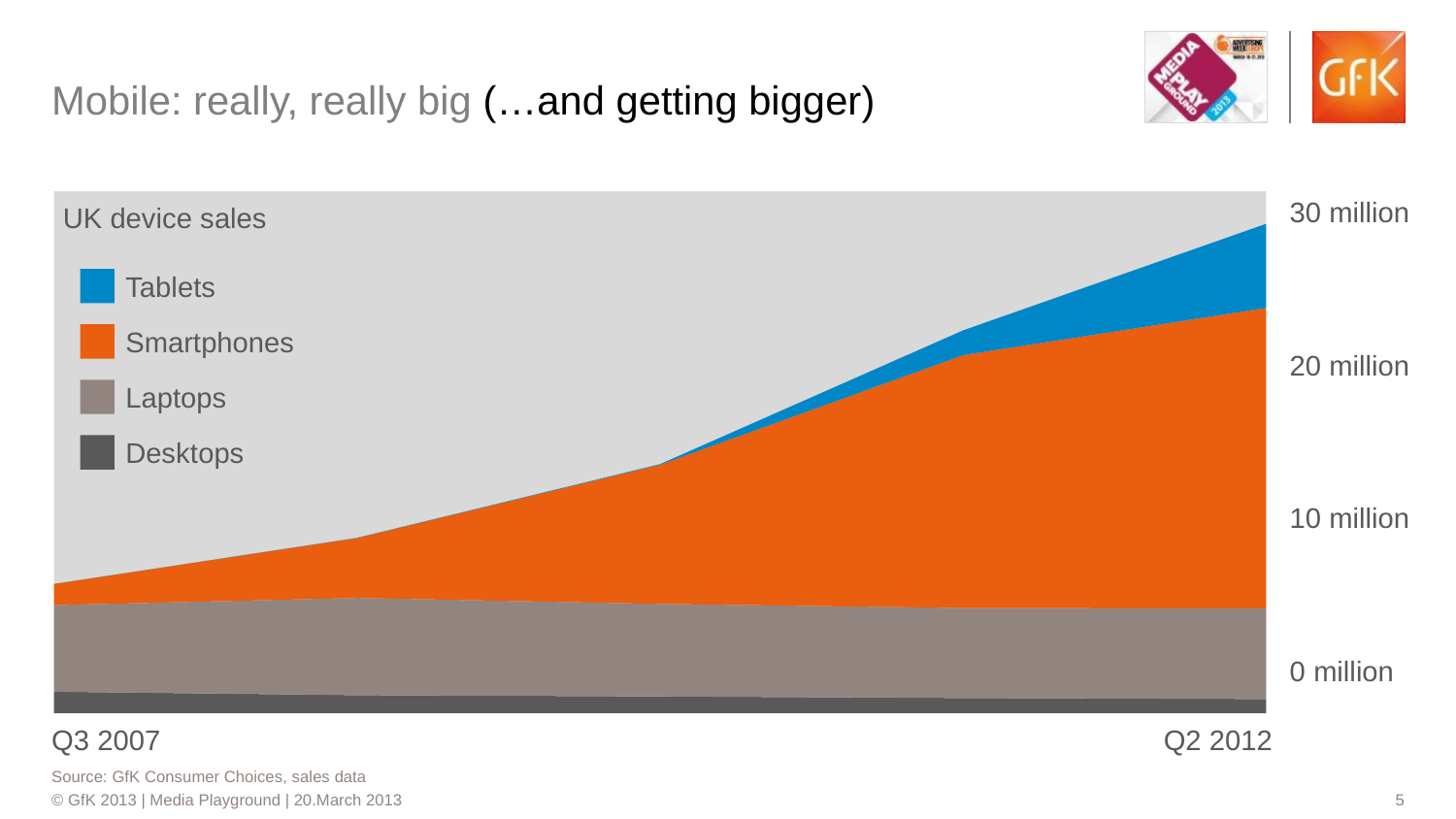
Is the total of UK device sales at Q3 2007 greater or less than 10 million? less At Q2 2012, are smartphone sales larger or smaller than desktop sales? Larger Which series accounts for the smallest share of UK device sales at Q2 2012? Desktops Which series accounts for the largest share of UK device sales at Q2 2012? Smartphones Do smartphone sales rise or fall from Q3 2007 to Q2 2012? Rise How many series does the legend list? 4 What is the title of the chart? UK device sales Are total UK device sales larger at Q3 2007 or at Q2 2012? Q2 2012 Which series is shown in blue? Tablets Is the total of UK device sales at Q2 2012 greater or less than 20 million? greater What kind of chart is shown on the slide? Stacked area chart Does the total of UK device sales rise or fall along the x axis? Rise